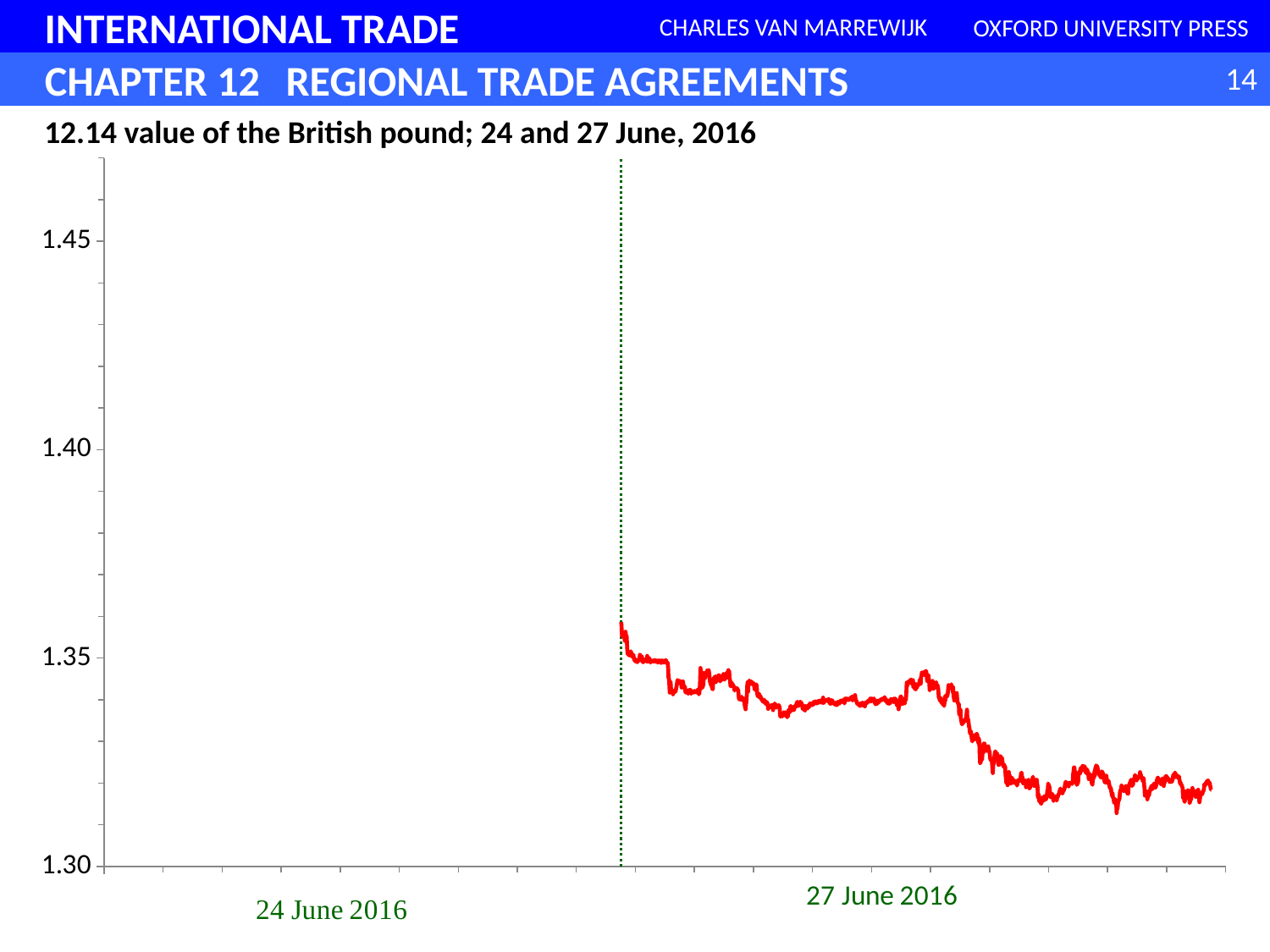
Which date label on the x axis has the plotted line above it, 24 June 2016 or 27 June 2016? 27 June 2016 Is the lowest value of the British pound plotted on 27 June 2016 greater or less than 1.30? greater How many date labels are shown on the x axis? 2 Is the highest value of the British pound plotted on 27 June 2016 greater or less than 1.40? less What kind of chart is shown on the slide? line chart What is the title of the chart? 12.14 value of the British pound; 24 and 27 June, 2016 Does the value of the British pound rise or fall over the course of 27 June 2016? fall Is the value of the British pound at the start of 27 June 2016 greater or less than 1.40? less What is the highest value labelled on the y axis? 1.45